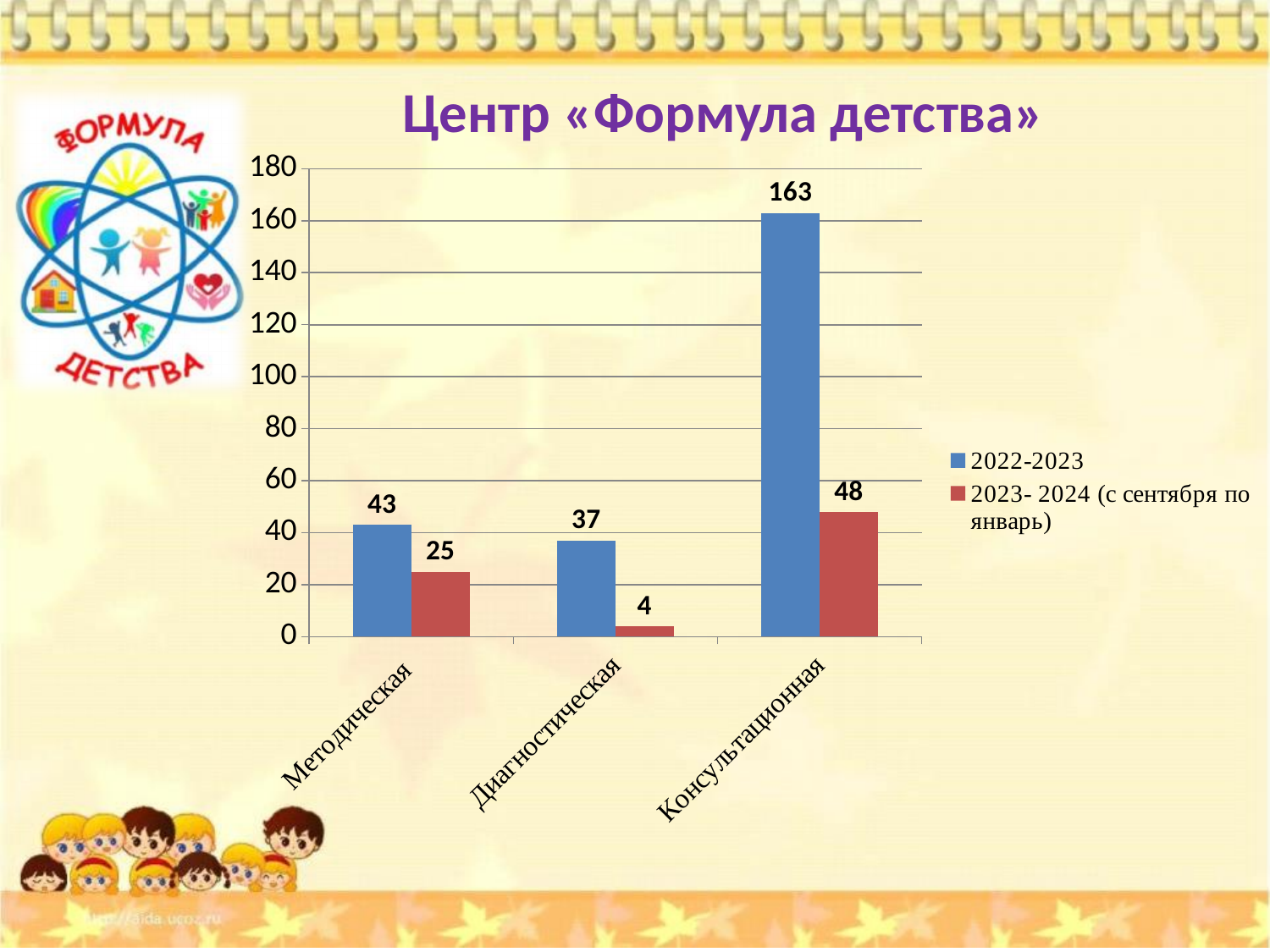
How many categories are shown on the x axis? 3 What is the value for Диагностическая in the 2023- 2024 (с сентября по январь) series? 4 What is the value for Методическая in the 2022-2023 series? 43 What is the value for Консультационная in the 2023- 2024 (с сентября по январь) series? 48 What kind of chart is shown on the slide? bar chart What is the difference between the 2022-2023 values for Методическая and Диагностическая? 6 Which category has the lowest value in the 2023- 2024 (с сентября по январь) series? Диагностическая Which is larger for Методическая: the 2022-2023 value or the 2023- 2024 value? 2022-2023 How many series does the legend list? 2 What is the difference between the 2022-2023 and 2023- 2024 values for Консультационная? 115 Which category has the highest value in the 2022-2023 series? Консультационная Is the 2022-2023 value for Консультационная greater or less than 140? greater